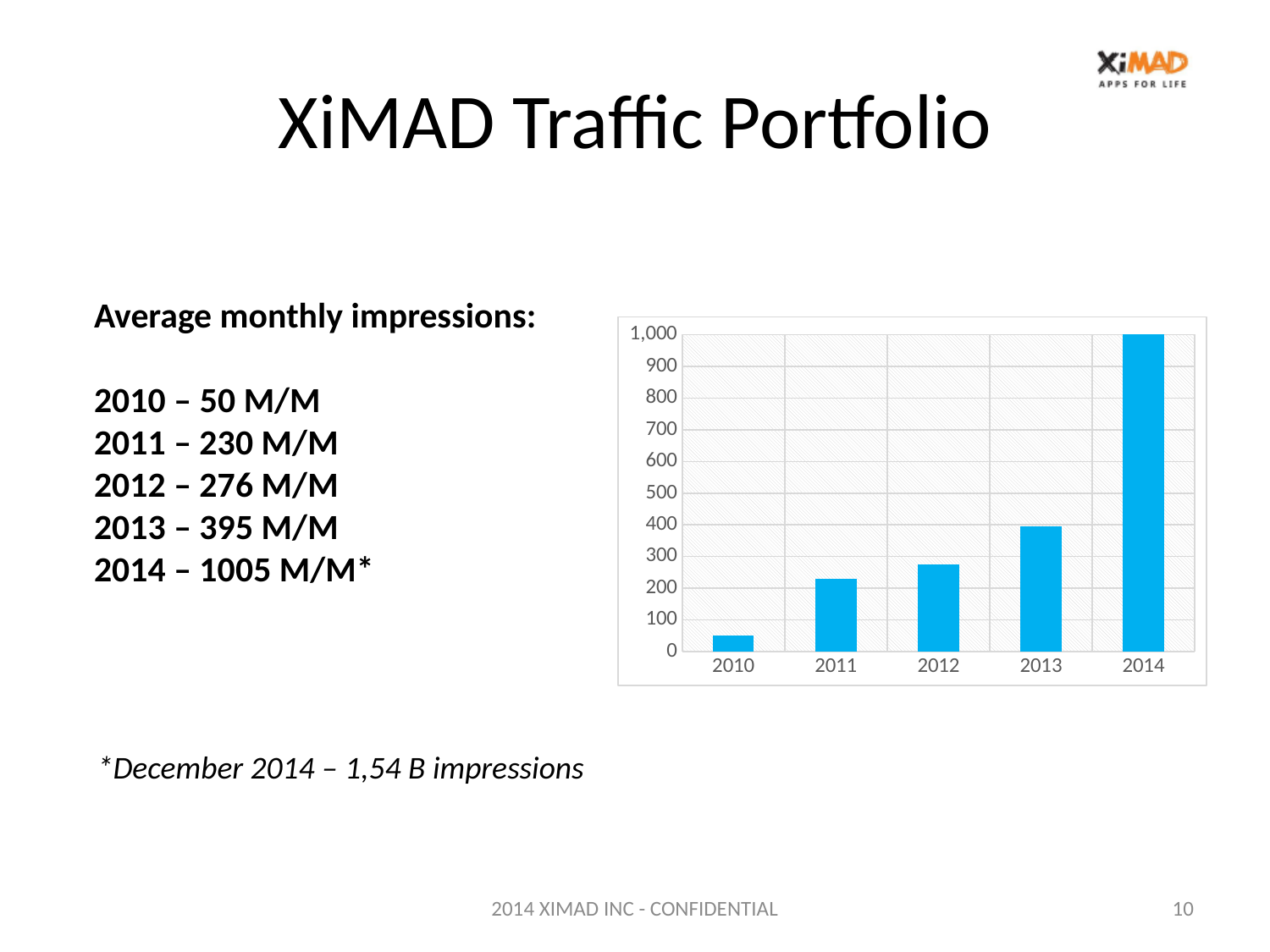
Which is larger, the value for 2012 or the value for 2013? 2013 Which year has the lowest bar in the chart? 2010 Is the value for 2011 greater or less than 300? less Is the value for 2012 greater or less than 200? greater According to the slide, what were the average monthly impressions in 2013? 395 M/M Is the value for 2013 greater or less than 300? greater What kind of chart is shown on the slide? bar chart According to the slide, what were the average monthly impressions in 2011? 230 M/M How many years are shown on the x axis of the chart? 5 Do the values in the chart rise or fall from 2010 to 2014? rise Which year has the highest bar in the chart? 2014 What is the difference between the average monthly impressions for 2013 and 2011 as listed on the slide? 165 M/M